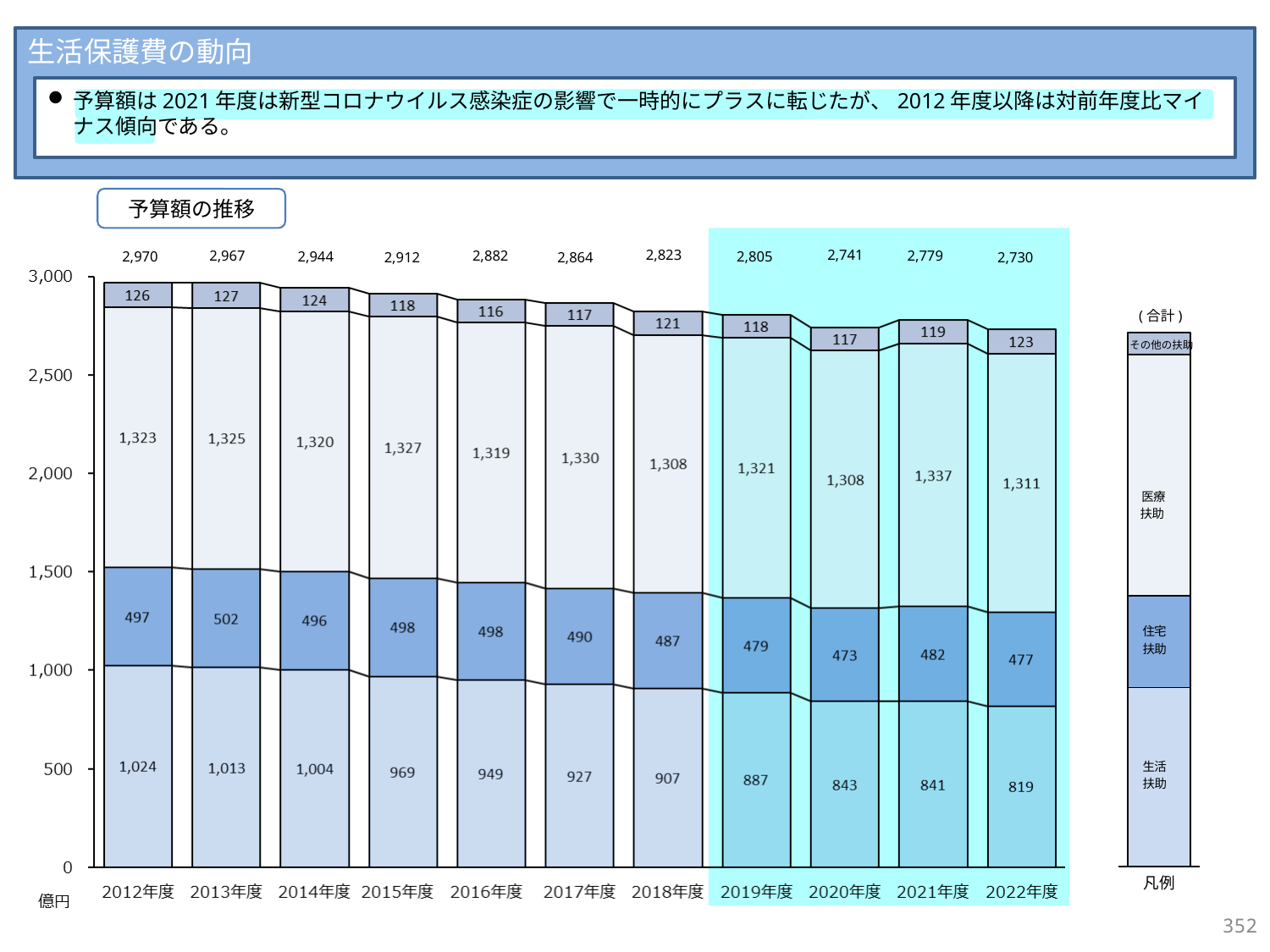
How many fiscal years are shown on the x axis? 11 What is the total of the stacked bar for 2019年度? 2,805 Which fiscal year has the highest total budget? 2012年度 Which fiscal year has the lowest total budget? 2022年度 How many categories of assistance does the legend (凡例) list? 4 Does the total budget generally rise or fall from 2012年度 to 2022年度? Fall What is the total budget shown above the bar for 2021年度? 2,779 What is the value of 生活扶助 for 2022年度? 819 What kind of chart is shown on the slide? Stacked bar chart How much larger is 生活扶助 in 2012年度 than in 2022年度? 205 What is the value of 医療扶助 for 2017年度? 1,330 Which is larger, the total budget for 2020年度 or for 2021年度? 2021年度